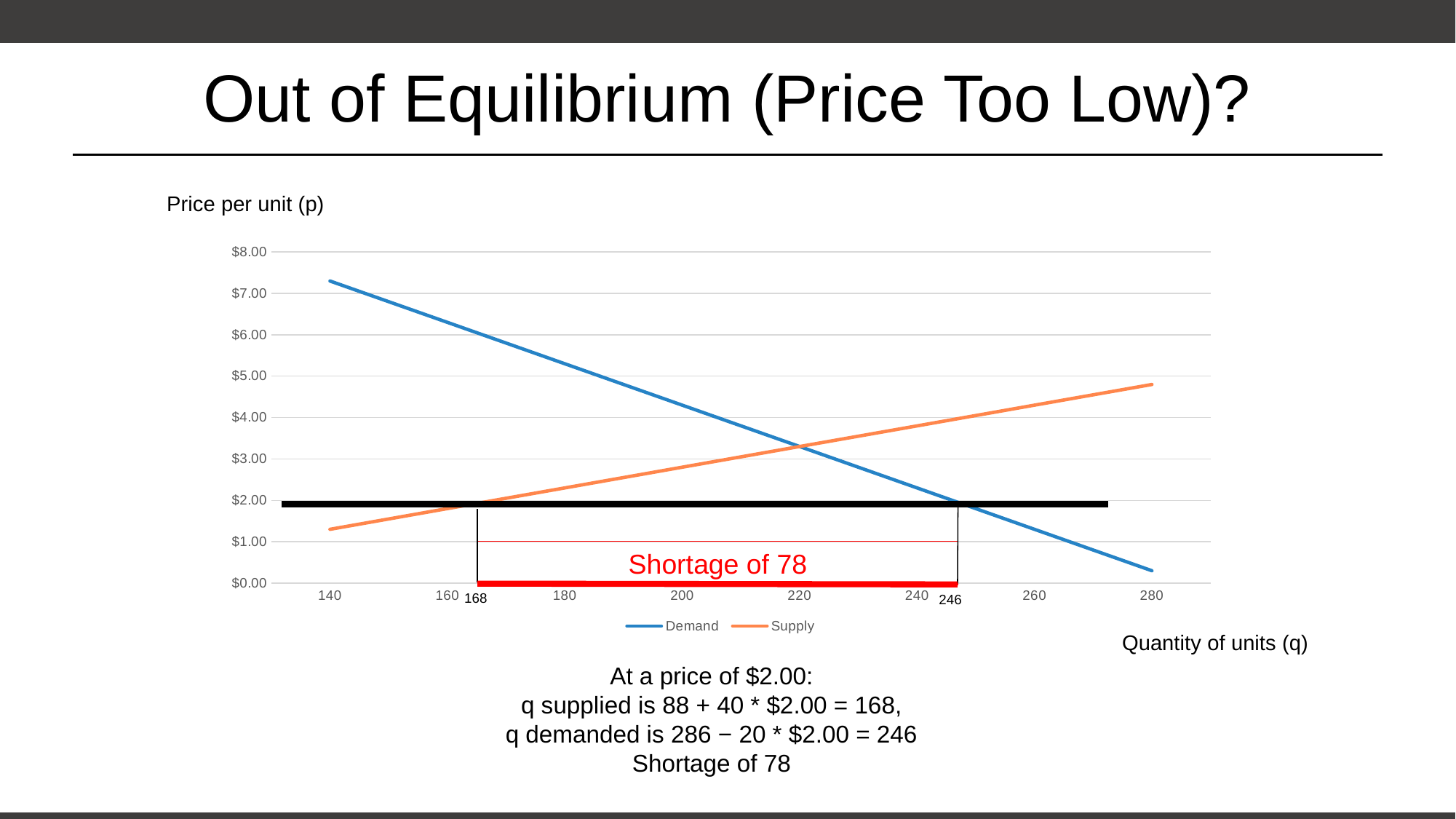
What is the difference between quantity demanded (246) and quantity supplied (168) at a price of $2.00? 78 What are the two series named in the chart's legend? Demand and Supply What is the label of the vertical axis of the chart? Price per unit (p) How many series does the chart's legend list? 2 At a price of $2.00, which is larger: quantity demanded or quantity supplied? quantity demanded Does the Demand line rise or fall as quantity increases along the x axis? fall At a price of $2.00, what is the quantity supplied shown on the chart? 168 What kind of chart is shown on the slide? line chart Is the price on the Demand line at a quantity of 140 greater or less than $7.00? greater Is the price on the Supply line at a quantity of 280 greater or less than $5.00? less At a price of $2.00, what is the quantity demanded shown on the chart? 246 Does the Supply line rise or fall as quantity increases along the x axis? rise